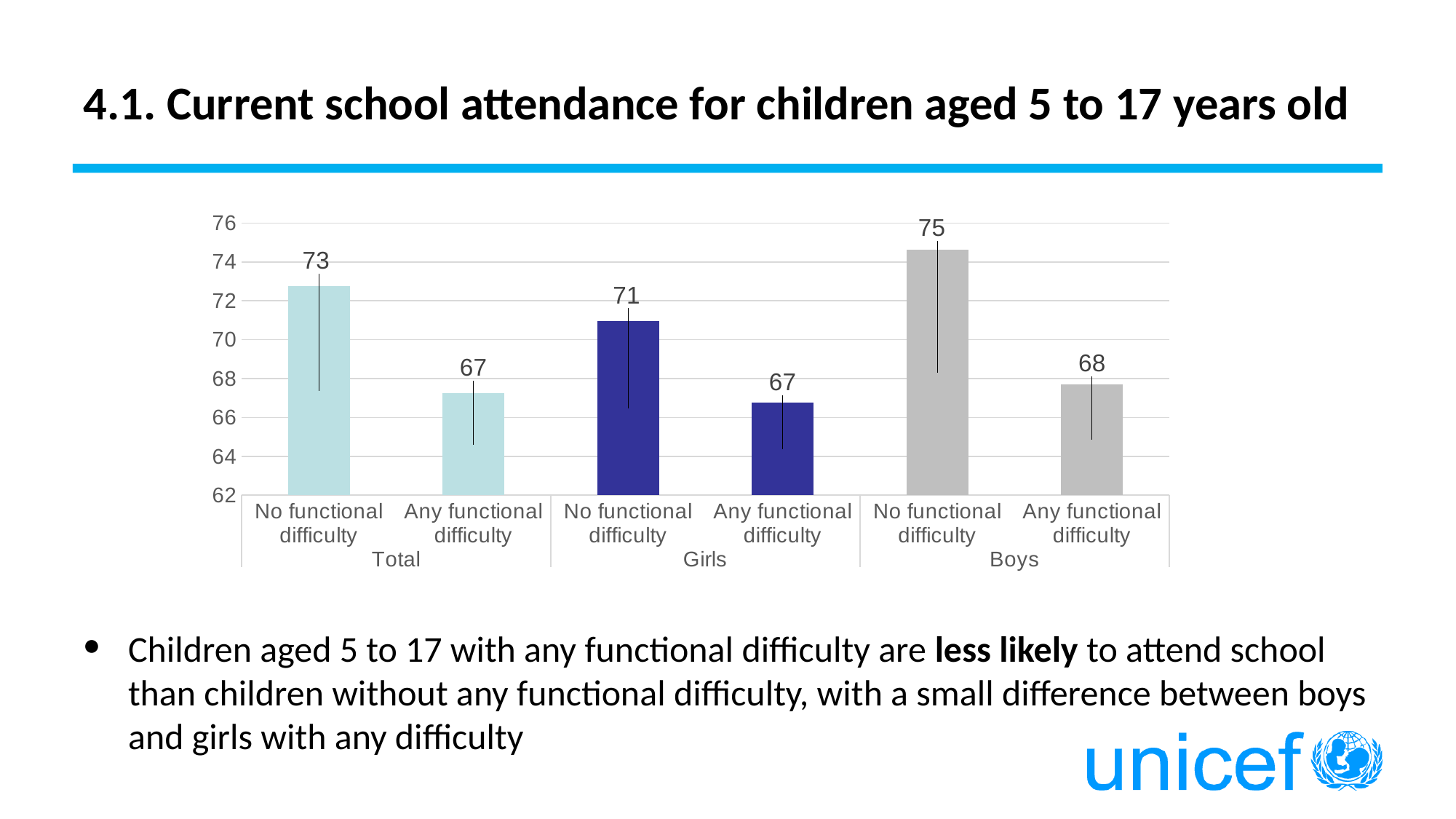
What is the value for 'No functional difficulty' in the Total group? 73 What is the difference between 'No functional difficulty' and 'Any functional difficulty' among Boys? 7 What are the three group labels shown along the x axis? Total, Girls, Boys What is the value for 'Any functional difficulty' among Boys? 68 What is the value for 'No functional difficulty' among Boys? 75 What type of chart is shown on the slide? Bar chart Which bar has the highest value on the chart? No functional difficulty, Boys Is the value for 'No functional difficulty' among Girls greater or less than 70? greater What is the difference between 'No functional difficulty' and 'Any functional difficulty' in the Total group? 6 Which is larger: 'No functional difficulty' for Girls or 'No functional difficulty' for Boys? No functional difficulty for Boys What is the value for 'Any functional difficulty' among Girls? 67 How many bars are plotted on the chart? 6